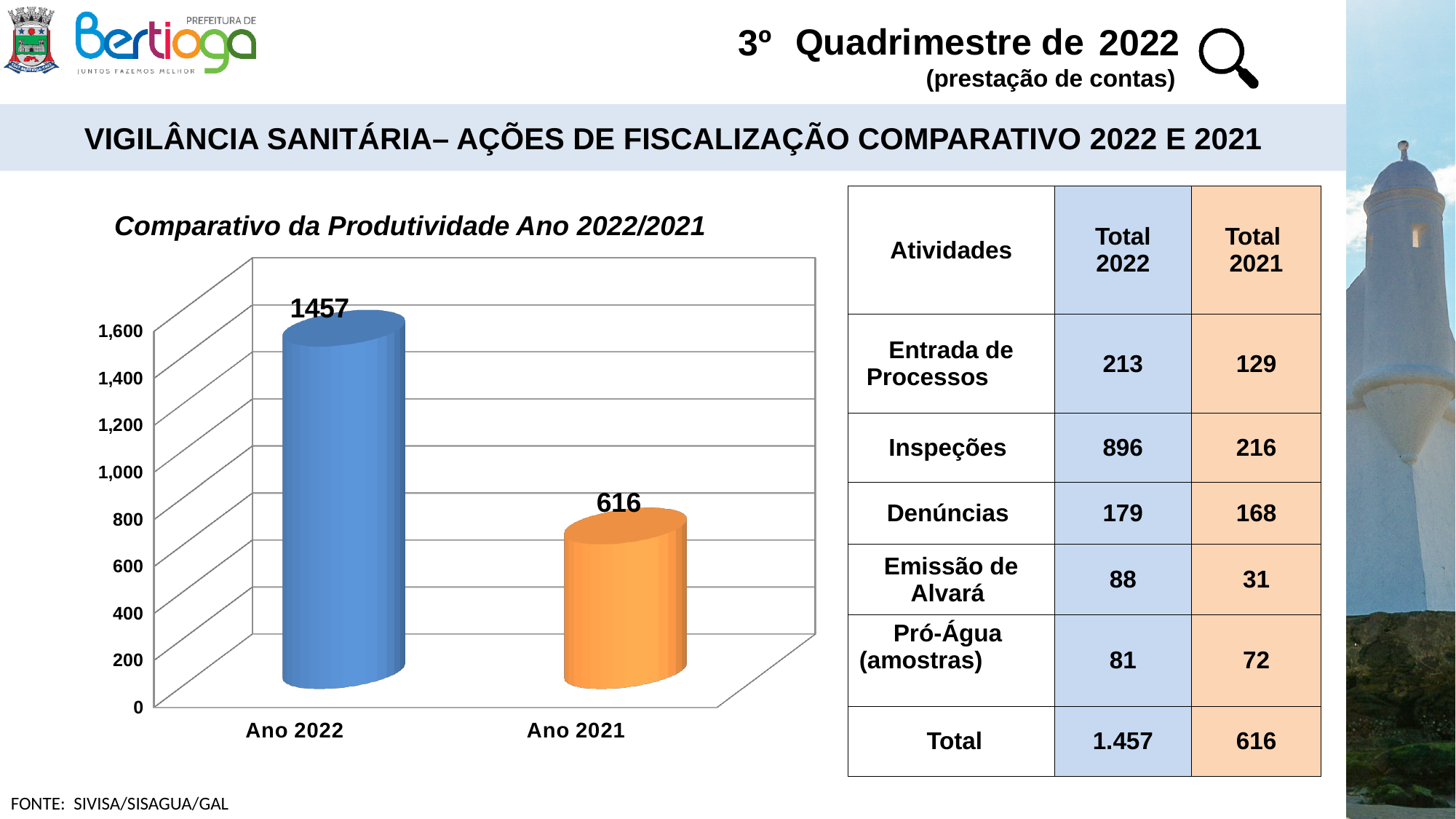
What is the value for Ano 2021 in the chart? 616 Which is larger, the value for Ano 2022 or the value for Ano 2021? Ano 2022 What colour is the bar for Ano 2021? orange What is the difference between the values for Ano 2022 and Ano 2021? 841 Is the value for Ano 2022 greater or less than 1,400? greater Is the value for Ano 2021 greater or less than 800? less What kind of chart is shown on the slide? bar chart Which category has the highest value in the chart? Ano 2022 Which category has the lowest value in the chart? Ano 2021 What is the value for Ano 2022 in the chart? 1457 How many categories are shown in the chart? 2 What is the title of the chart? Comparativo da Produtividade Ano 2022/2021